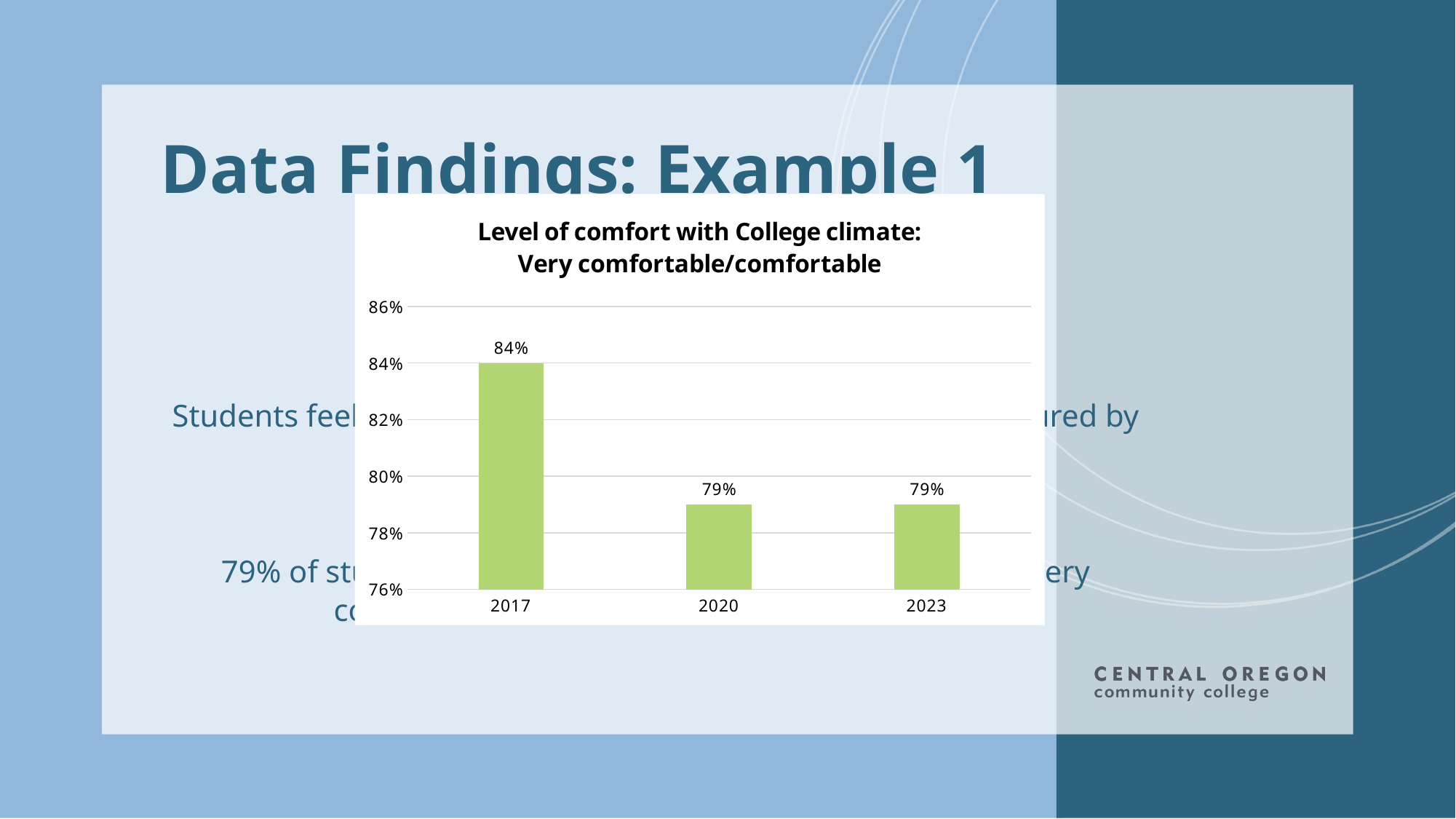
Which year has the highest value? 2017 What is the difference between the values for 2017 and 2020? 5% What kind of chart is this? bar chart Is the value for 2017 greater or less than 82%? greater Is the value for 2020 greater or less than 80%? less How many years are shown on the x axis? 3 What is the title of the chart? Level of comfort with College climate: Very comfortable/comfortable What is the value for 2017? 84% Which is larger, the value for 2017 or the value for 2023? 2017 What is the value for 2023? 79% What is the value for 2020? 79% Do the values rise or fall from 2017 to 2020? fall